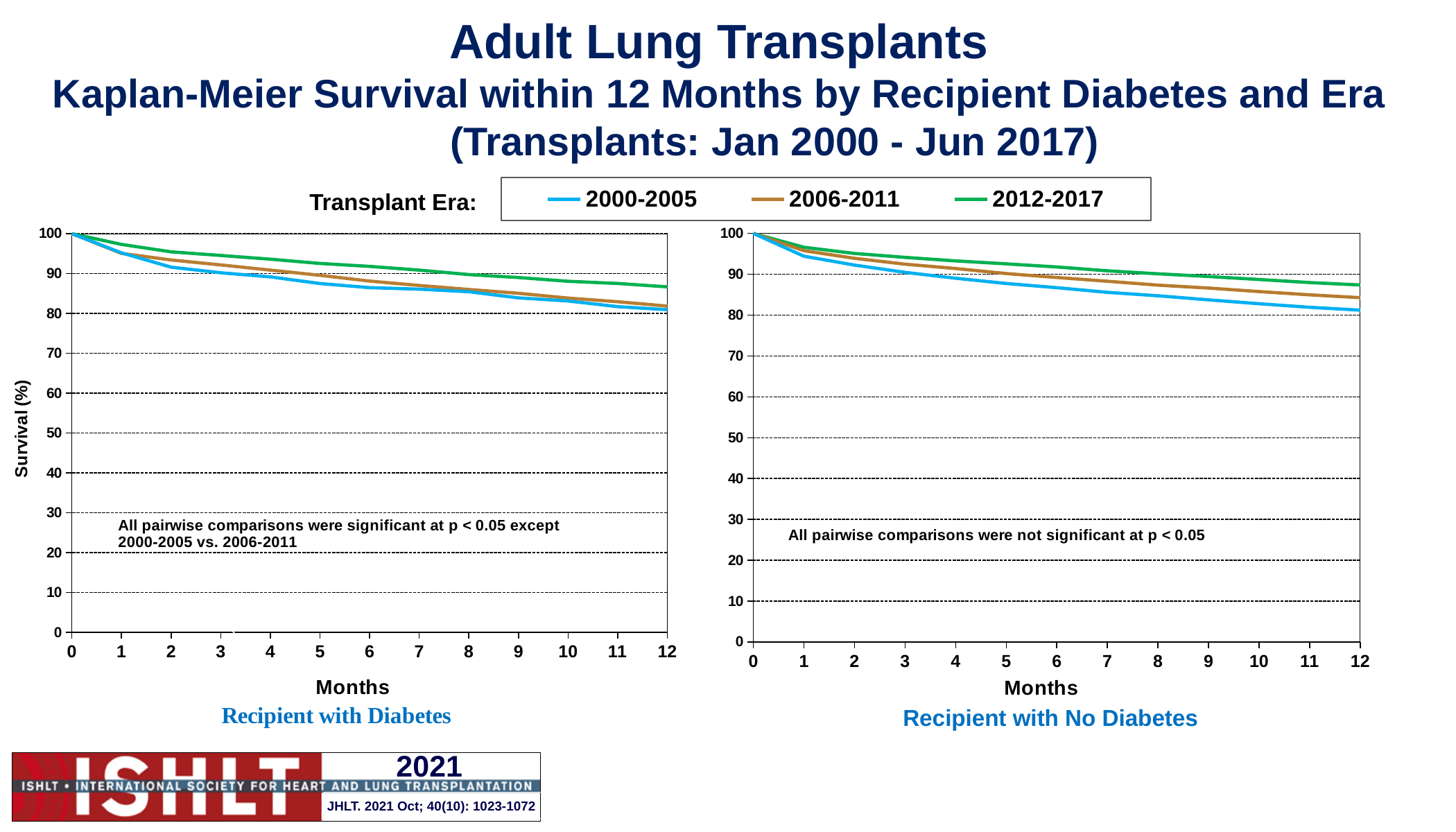
What is the label of the y axis on the left chart? Survival (%) In the 'Recipient with Diabetes' chart, is the survival for 2012-2017 at 12 months greater or less than 80? greater In the 'Recipient with Diabetes' chart, which era has the highest survival at 12 months? 2012-2017 In the 'Recipient with Diabetes' chart, do the survival curves rise or fall as months increase? fall In the 'Recipient with No Diabetes' chart, which era has the lowest survival at 12 months? 2000-2005 In the 'Recipient with No Diabetes' chart, is the survival for 2000-2005 at 6 months greater or less than 80? greater Which colour represents the 2006-2011 era in the legend? brown In the 'Recipient with No Diabetes' chart, what is the survival value for every era at 0 months? 100 In the 'Recipient with No Diabetes' chart, which era has higher survival at 12 months, 2012-2017 or 2000-2005? 2012-2017 How many transplant eras does the legend list? 3 What kind of chart is the 'Recipient with Diabetes' chart? line chart In the 'Recipient with Diabetes' chart, is the survival for 2000-2005 at 12 months greater or less than 90? less